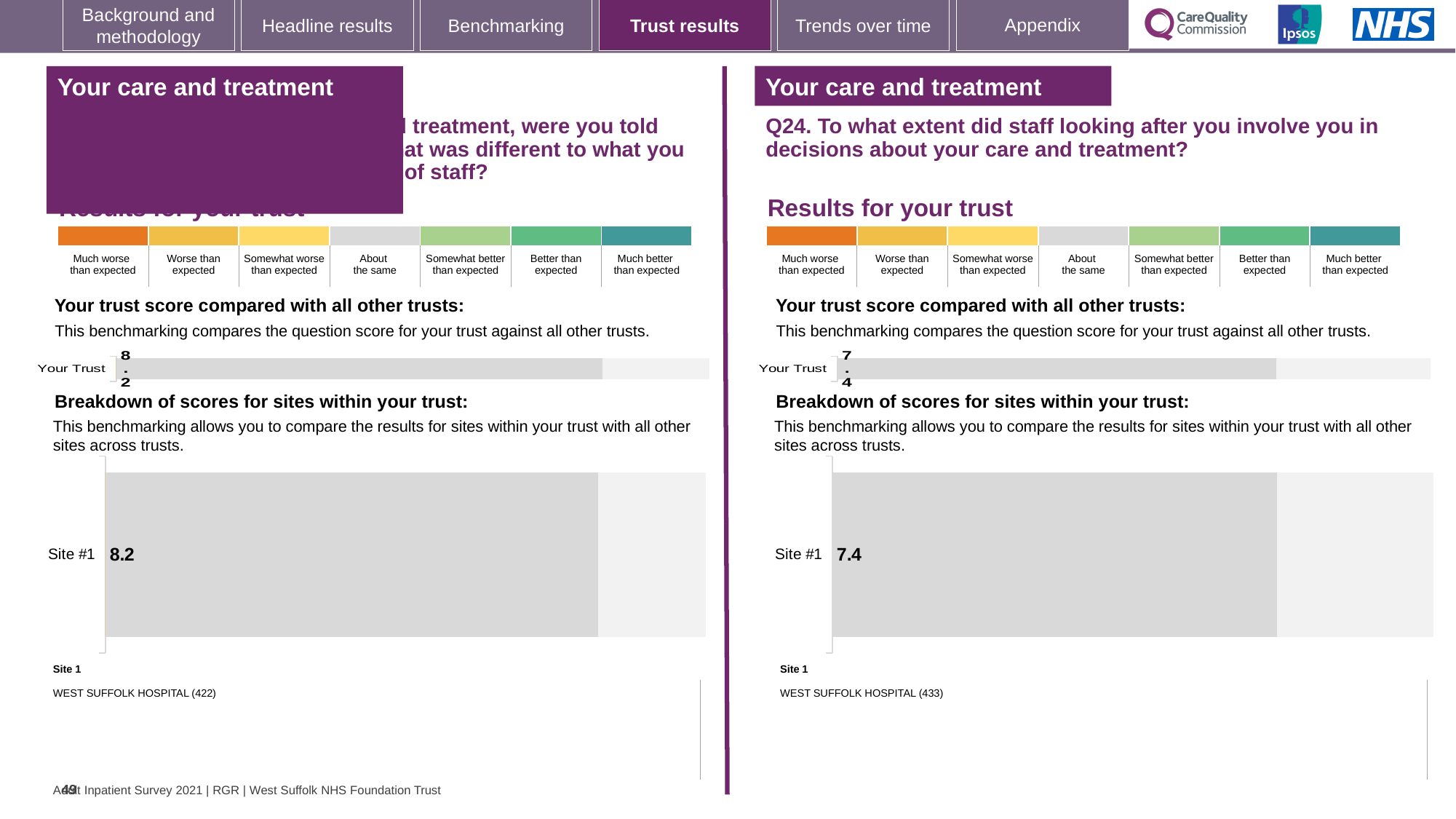
Which is larger: the Site #1 score on the left-hand panel or the Site #1 score on the right-hand panel (Q24)? Left-hand panel (8.2) What is the difference between the Site #1 score on the left-hand panel and the Site #1 score on the right-hand panel (Q24)? 0.8 On the left-hand panel, what is the score shown for Site #1 in the breakdown of scores for sites within your trust? 8.2 On the left-hand panel, which site name is listed as Site 1 below the chart? WEST SUFFOLK HOSPITAL (422) On the left-hand panel, what is the score shown for 'Your Trust' in the trust score comparison chart? 8.2 How many sites are shown in the breakdown of scores chart on the left-hand panel? 1 What type of chart is used for the breakdown of scores for sites on the right-hand panel (Q24)? Bar chart On the right-hand panel (Q24), which site name is listed as Site 1 below the chart? WEST SUFFOLK HOSPITAL (433) How many sites are shown in the breakdown of scores chart on the right-hand panel (Q24)? 1 On the right-hand panel (Q24), what is the score shown for 'Your Trust' in the trust score comparison chart? 7.4 On the right-hand panel (Q24), what is the score shown for Site #1 in the breakdown of scores for sites within your trust? 7.4 On the right-hand panel (Q24), is the Site #1 score greater or less than the 'Your Trust' score? Equal (both 7.4)